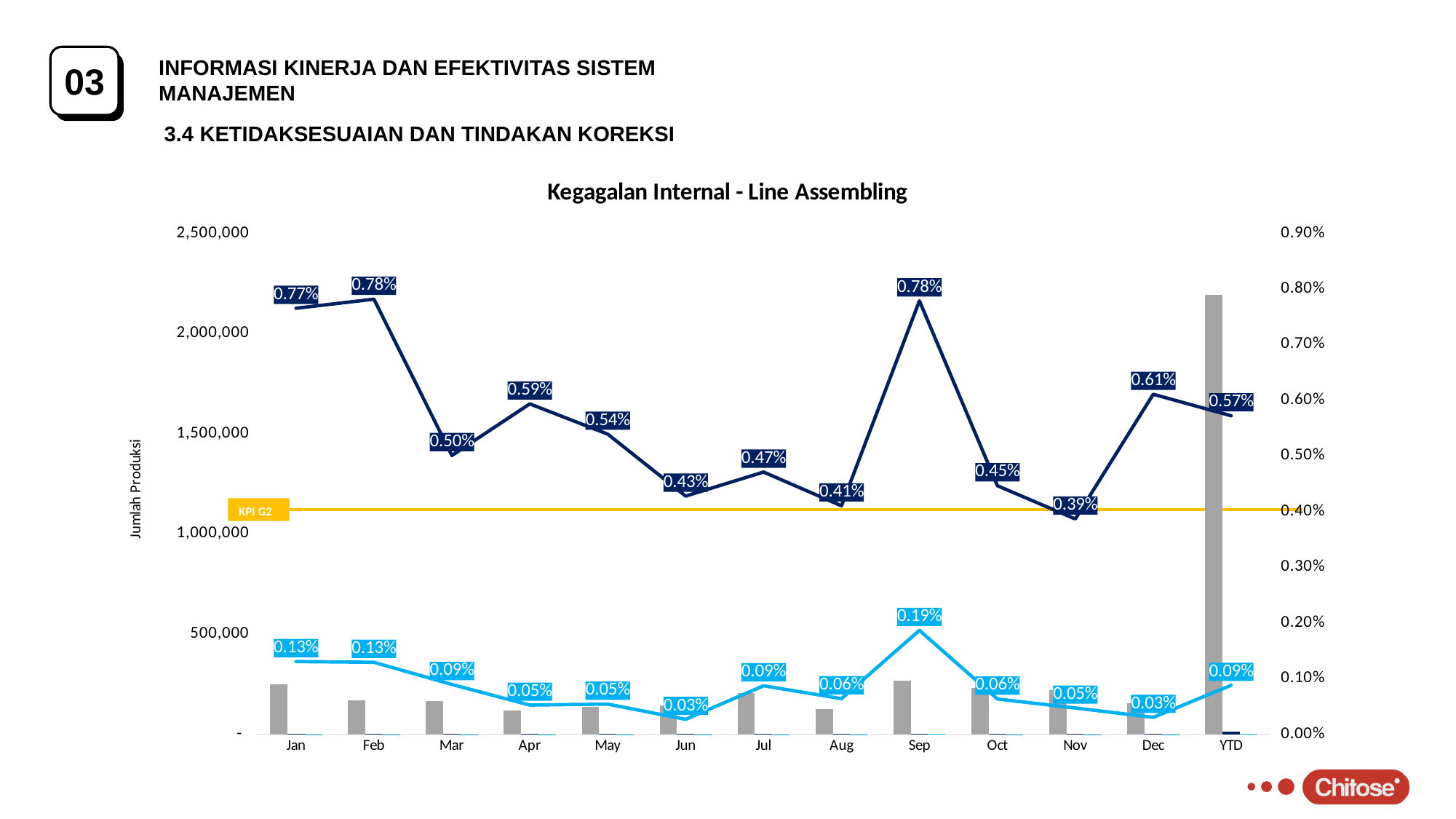
What value does the light blue line show for Jan? 0.13% What value does the dark blue line show for Sep? 0.78% What is the title of the chart on the slide? Kegagalan Internal - Line Assembling Is the gray bar for YTD greater or less than 2,000,000? greater What value does the dark blue line show for YTD? 0.57% In which month does the light blue line reach its highest value? Sep What is the difference between the dark blue line's value for Sep and its value for Nov? 0.39% Which is larger on the dark blue line: the value for Dec or the value for Oct? Dec How many categories are shown on the x axis? 13 In which month does the dark blue line reach its lowest value? Nov At what percentage level is the KPI G2 line drawn? 0.40% Does the dark blue line rise or fall from Feb to Mar? fall